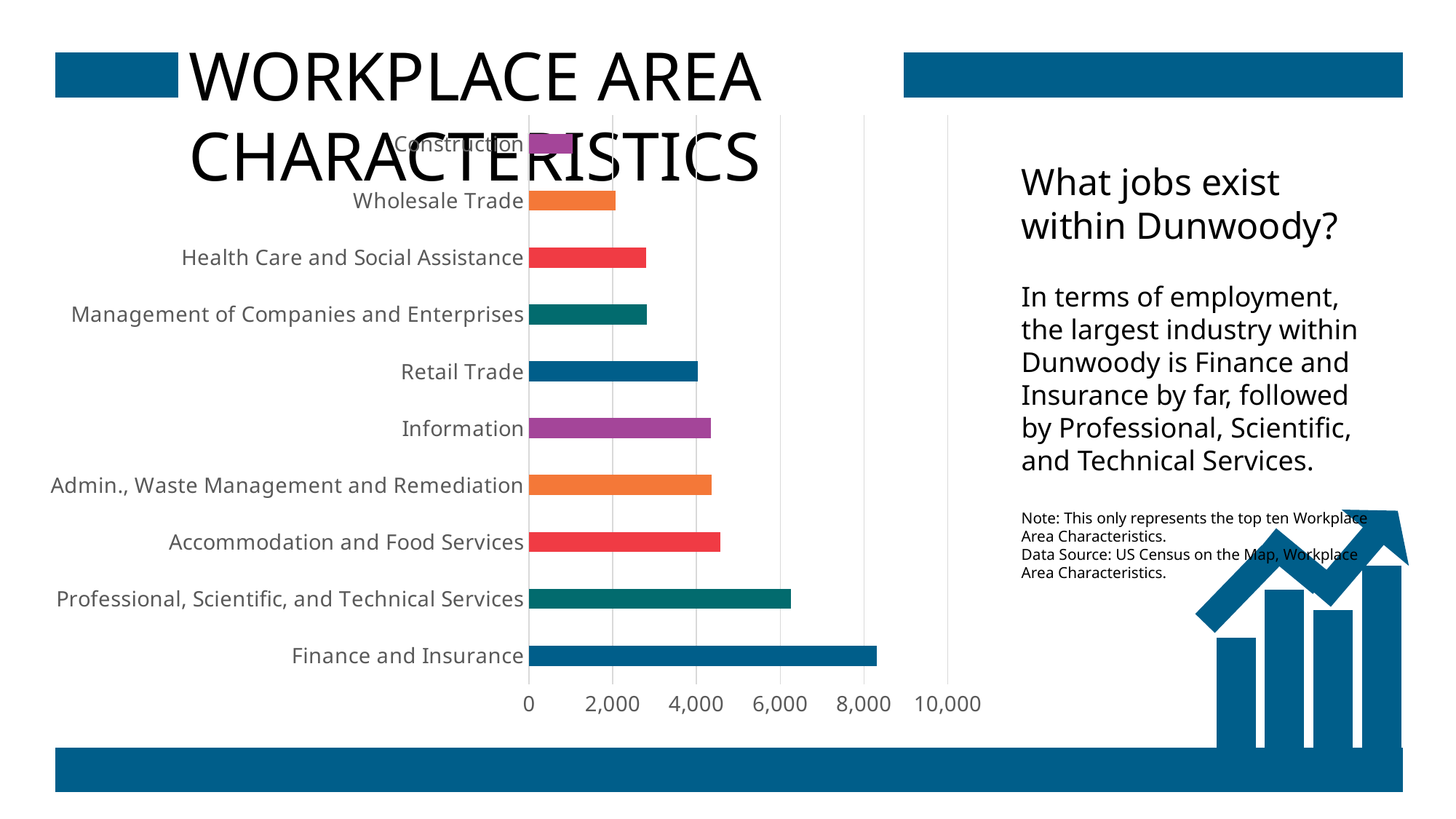
Is the value for Accommodation and Food Services greater or less than 4,000? greater Is the value for Professional, Scientific, and Technical Services greater or less than 8,000? less What is the highest value shown on the chart's horizontal axis? 10,000 Is the value for Health Care and Social Assistance greater or less than 4,000? less What kind of chart is shown on the slide? bar chart Which industry has the highest value in the chart? Finance and Insurance How many industry categories are plotted in the chart? 10 Which is larger, the value for Finance and Insurance or the value for Professional, Scientific, and Technical Services? Finance and Insurance Which industry has the lowest value in the chart? Construction Which is larger, the value for Retail Trade or the value for Wholesale Trade? Retail Trade